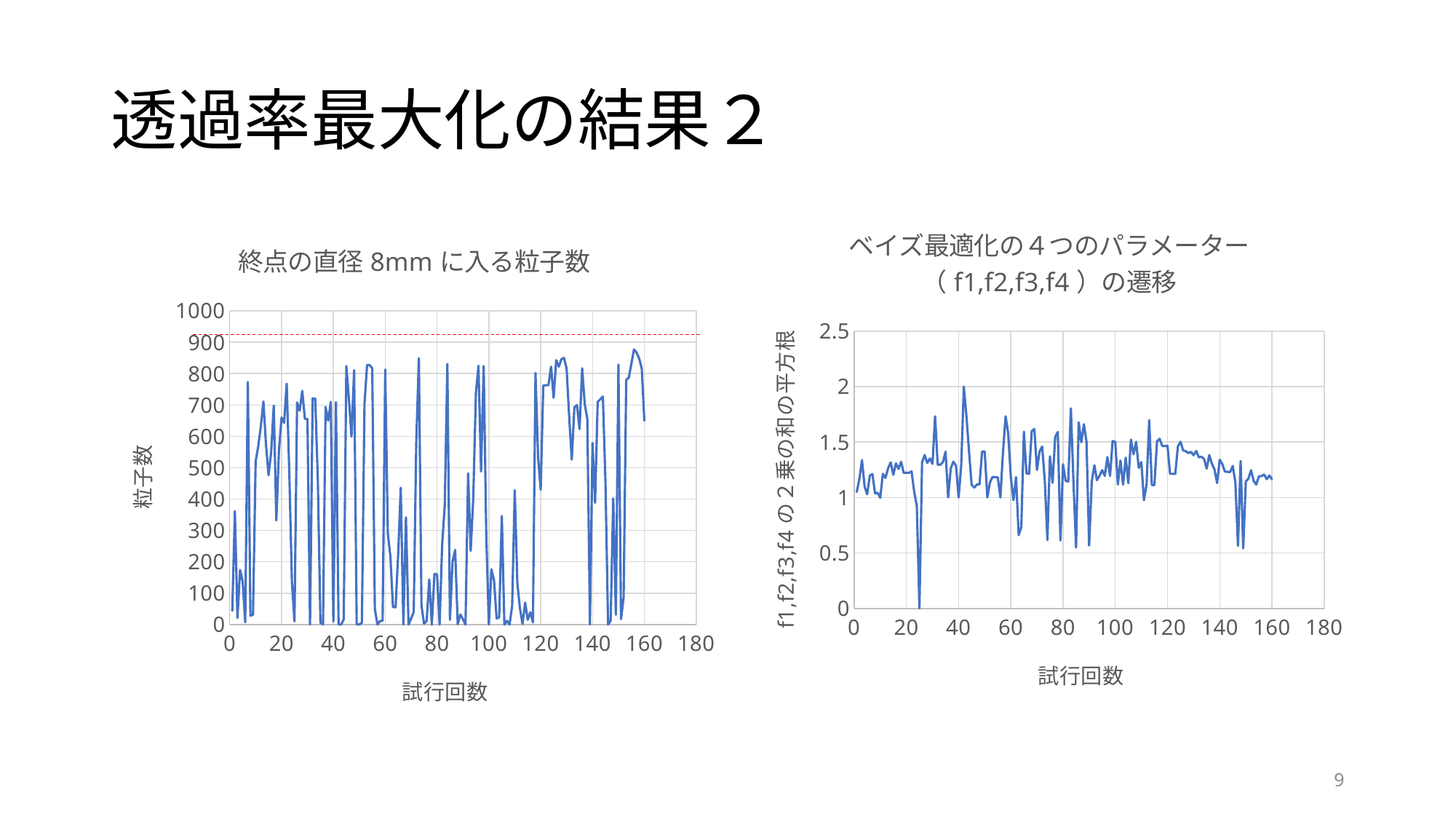
In the right chart (ベイズ最適化の４つのパラメーター（f1,f2,f3,f4）の遷移), is the lowest point of the line (around 試行回数 25) greater or less than 0.5? less In the right chart (ベイズ最適化の４つのパラメーター（f1,f2,f3,f4）の遷移), is the value at the last point (試行回数 160) greater or less than 1? greater In the right chart (ベイズ最適化の４つのパラメーター（f1,f2,f3,f4）の遷移), is the highest peak of the line (around 試行回数 40) greater or less than 1.5? greater In the left chart (終点の直径 8mm に入る粒子数), what is the label of the y axis? 粒子数 In the right chart (ベイズ最適化の４つのパラメーター（f1,f2,f3,f4）の遷移), what is the label of the x axis? 試行回数 What kind of chart is the right chart titled ベイズ最適化の４つのパラメーター（f1,f2,f3,f4）の遷移? line chart In the right chart (ベイズ最適化の４つのパラメーター（f1,f2,f3,f4）の遷移), does the line generally rise or fall between 試行回数 120 and 160? fall What kind of chart is the left chart titled 終点の直径 8mm に入る粒子数? line chart